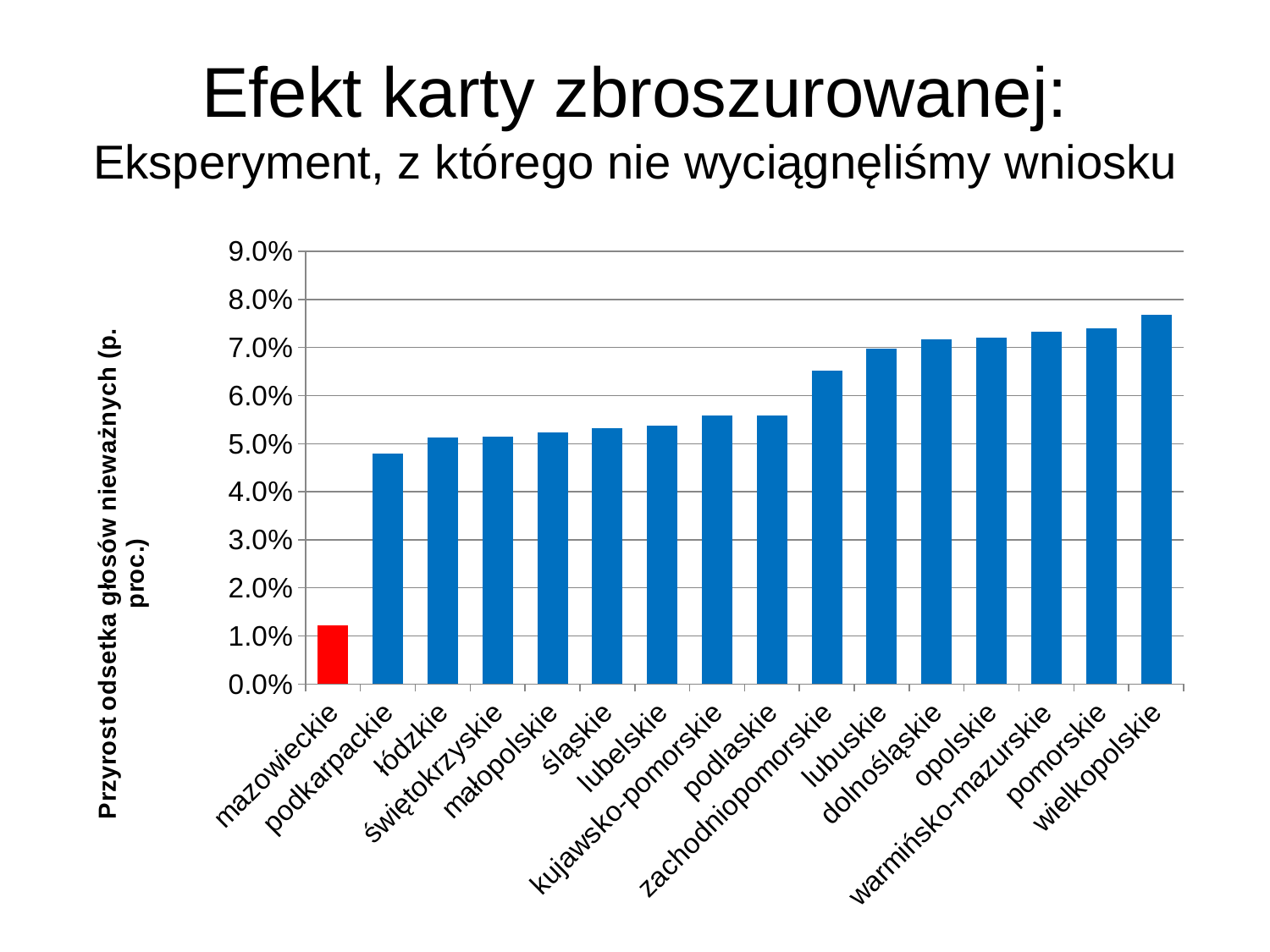
Is the value for podkarpackie greater or less than 5.0%? less Which bar is coloured red instead of blue? mazowieckie Is the value for zachodniopomorskie greater or less than 6.0%? greater How many voivodeships (categories) are plotted on the x axis? 16 Which category has the lowest value? mazowieckie What kind of chart is shown on the slide? bar chart Is the value for wielkopolskie greater or less than 7.0%? greater Which category has the highest value? wielkopolskie Which is larger, the value for zachodniopomorskie or the value for podlaskie? zachodniopomorskie Do the values generally rise or fall from left to right along the x axis? rise